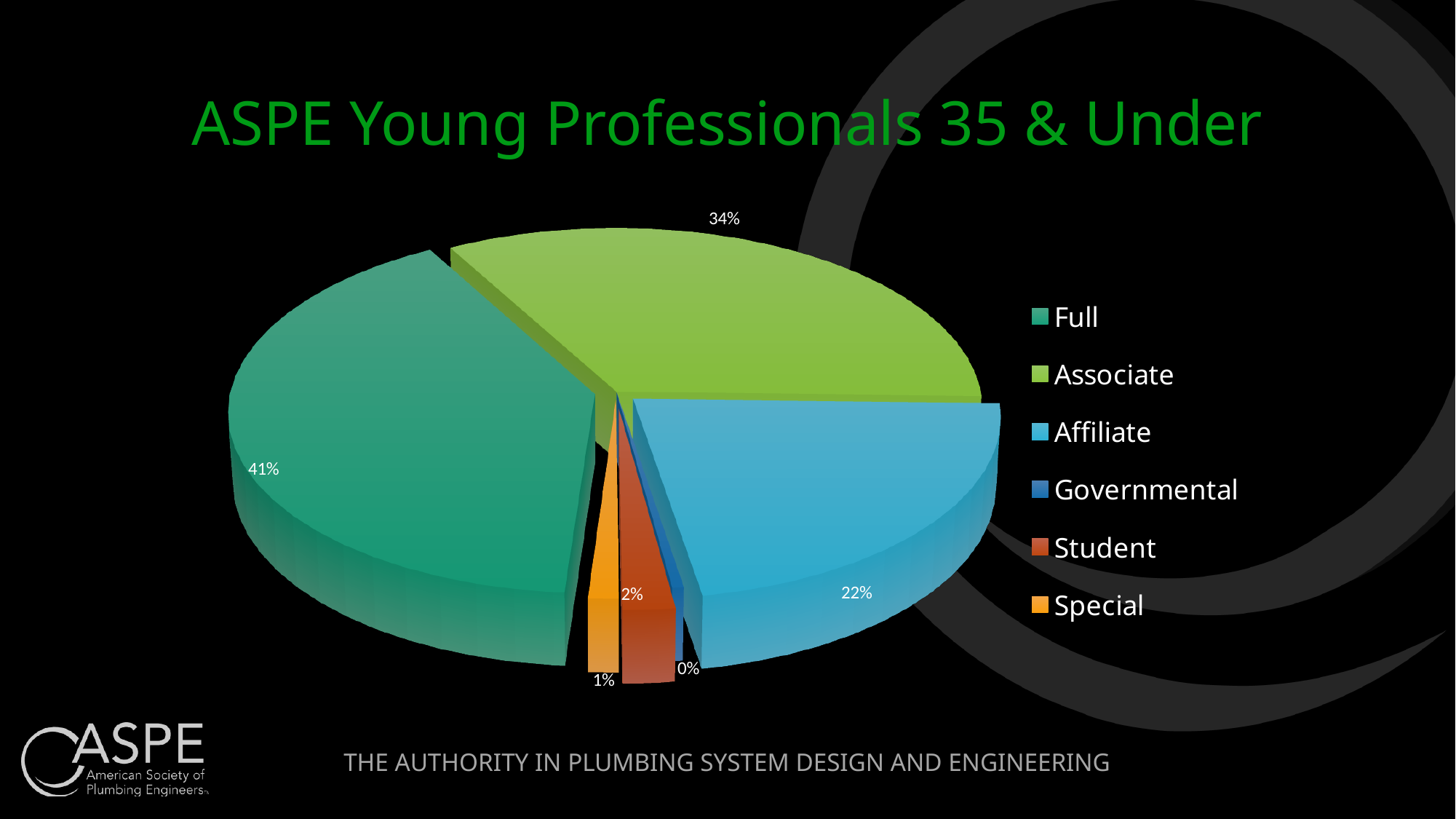
How many categories does the legend list? 6 What share of the pie does the Student category hold? 2% What share of the pie does the Full category hold? 41% Which is larger, the Affiliate share or the Associate share? Associate Which category has the smallest share of the pie? Governmental What share of the pie does the Affiliate category hold? 22% What is the difference between the Full share and the Associate share? 7% Which category has the largest share of the pie? Full What type of chart is shown on the slide? Pie chart